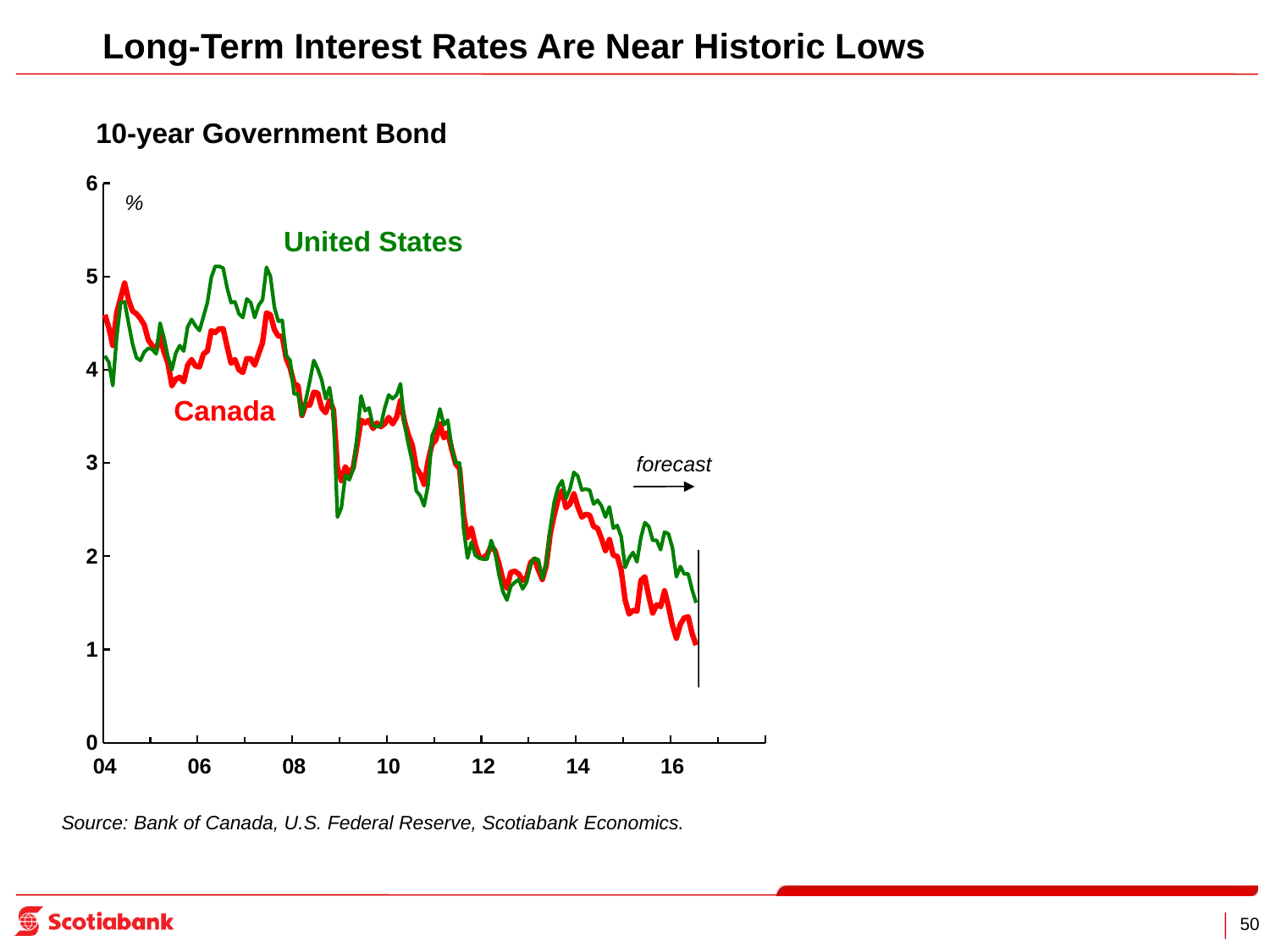
How many series are plotted on the chart? 2 Do the 10-year government bond yields generally rise or fall from 2004 to 2016? fall Is the value for Canada at the end of the series (2016) greater or less than 2? less In 2016, which series has the lower value, United States or Canada? Canada In 2006, which series has the higher value, United States or Canada? United States Is the value for Canada in 2012 greater or less than 3? less What colour is the Canada line on the chart? red What is the title of the chart? 10-year Government Bond Is the value for Canada in 2004 greater or less than 4? greater What kind of chart is shown on the slide? line chart